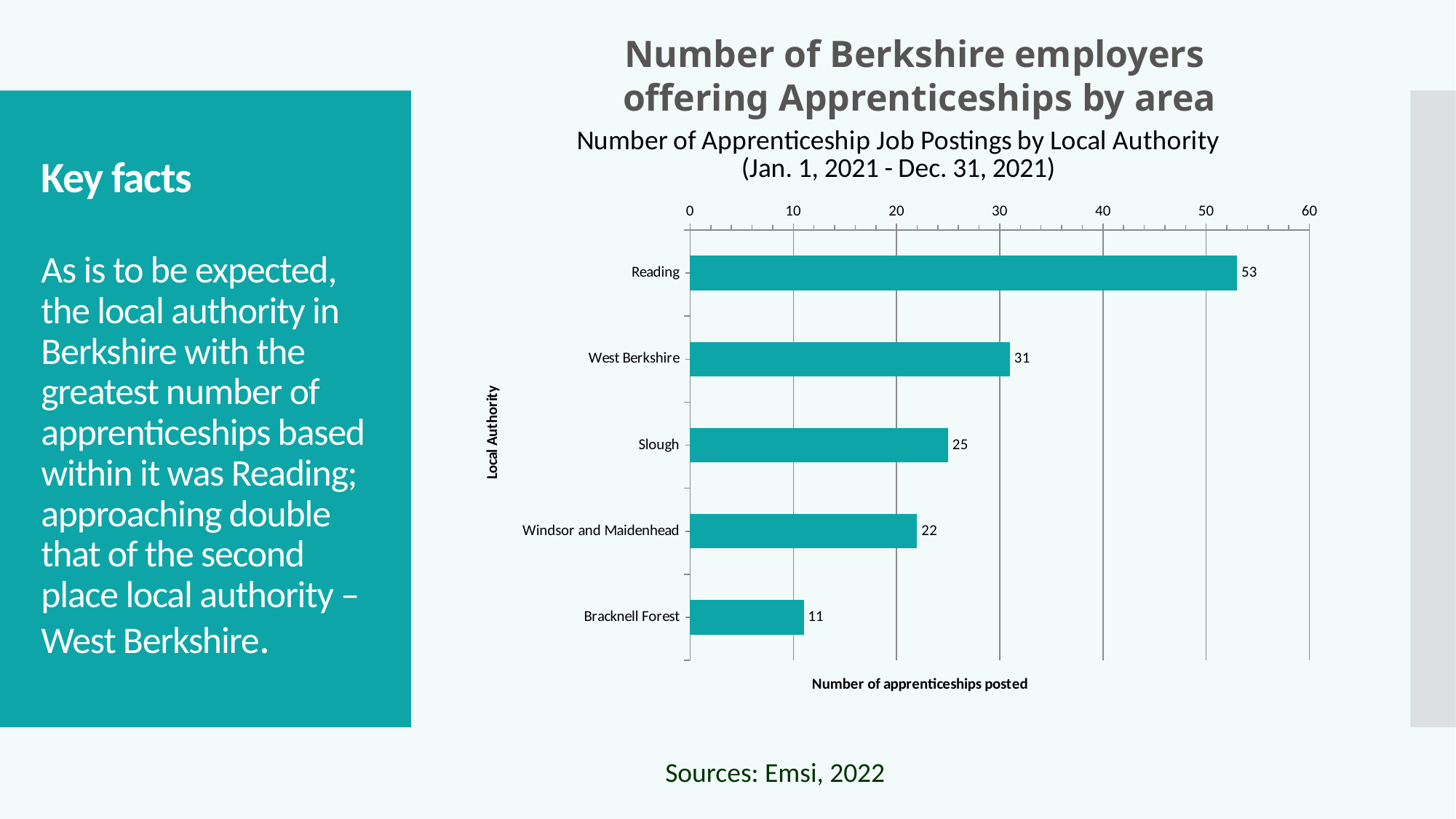
What is the difference between the number of postings for Reading and West Berkshire? 22 What kind of chart is shown on the slide? Bar chart Which has more apprenticeship job postings, Slough or Windsor and Maidenhead? Slough Which local authority has the highest number of apprenticeship job postings? Reading Is the value for West Berkshire greater or less than 30? greater What is the number of apprenticeship job postings for Slough? 25 What is the number of apprenticeship job postings for Bracknell Forest? 11 What is the label of the horizontal axis of the chart? Number of apprenticeships posted What is the number of apprenticeship job postings for Reading? 53 What is the difference between the number of postings for Windsor and Maidenhead and Bracknell Forest? 11 Which local authority has the lowest number of apprenticeship job postings? Bracknell Forest How many local authorities are shown in the chart? 5